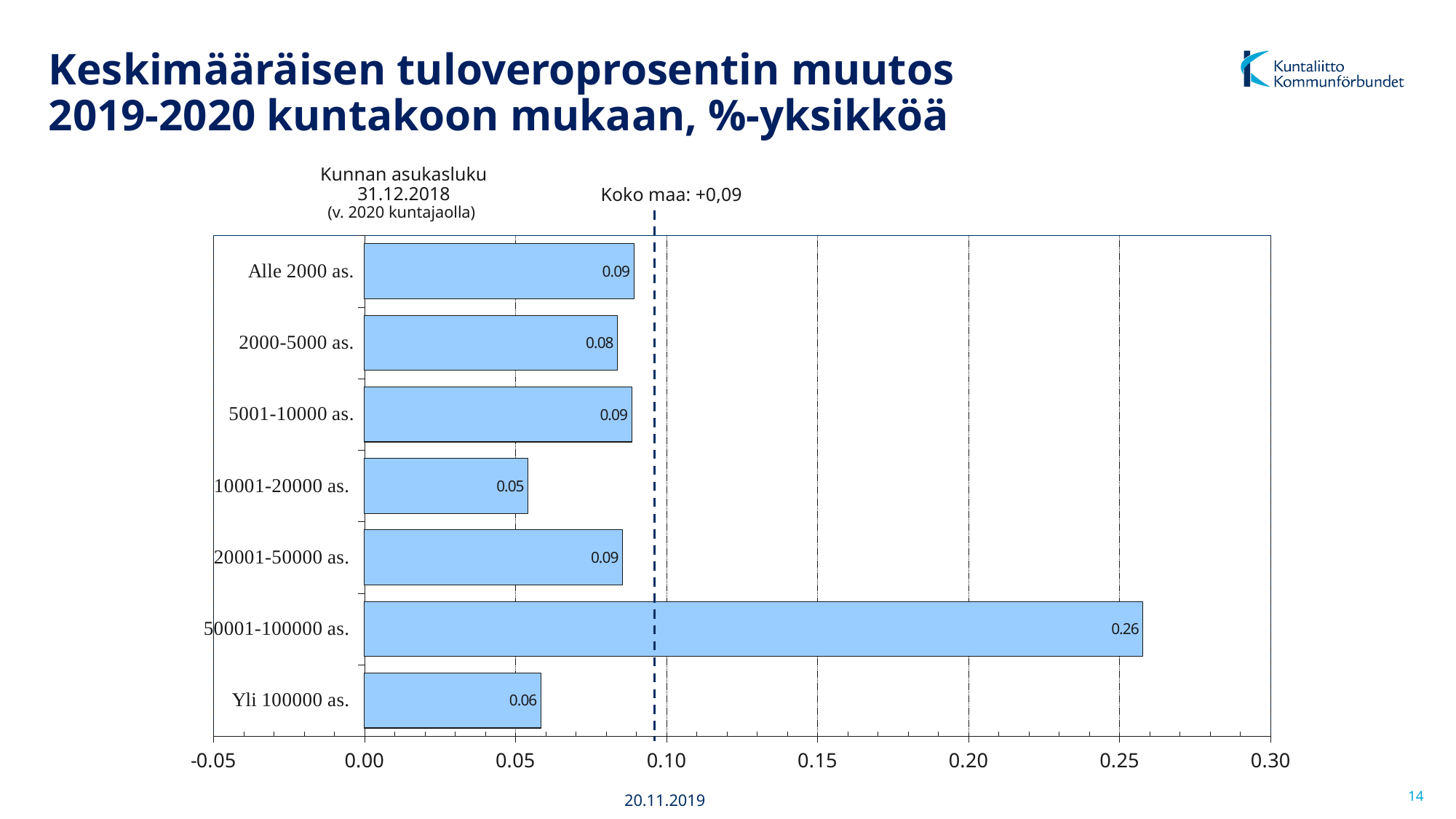
What kind of chart is shown on the slide? bar chart What is the difference between the values for 50001-100000 as. and 10001-20000 as.? 0.21 What is the value for the 50001-100000 as. category? 0.26 How many categories are shown in the chart? 7 What is the value for the 2000-5000 as. category? 0.08 What is the value for the Yli 100000 as. category? 0.06 Which category has the lowest value? 10001-20000 as. Is the value for 50001-100000 as. greater or less than 0.20? greater Which is larger, the value for 2000-5000 as. or the value for Yli 100000 as.? 2000-5000 as. Which category has the highest value? 50001-100000 as. What is the value for the 10001-20000 as. category? 0.05 What is the difference between the values for Alle 2000 as. and Yli 100000 as.? 0.03